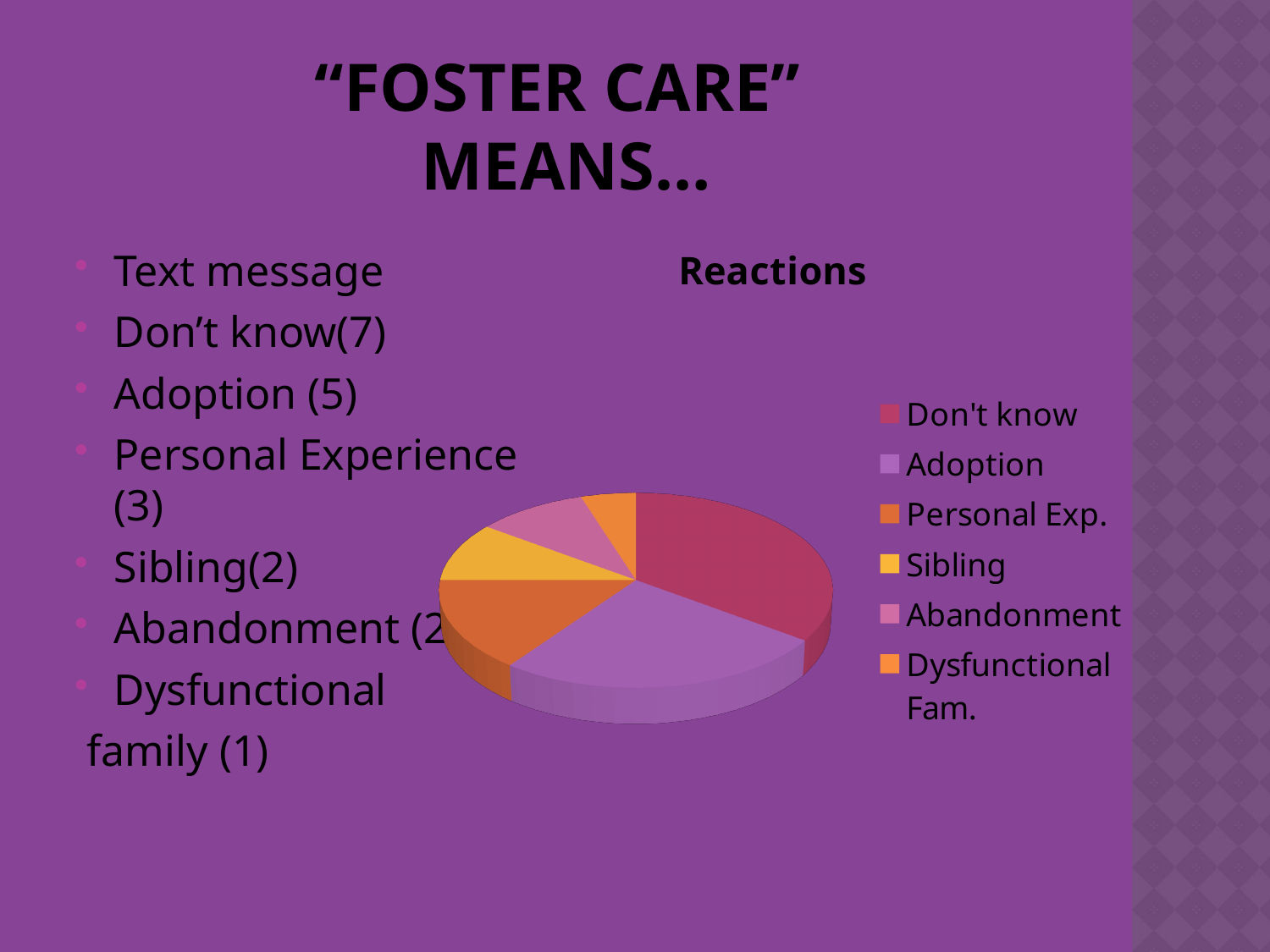
Which slice is larger, Adoption or Personal Exp.? Adoption How many slices does the pie chart have? 6 Which slice is larger, Personal Exp. or Dysfunctional Fam.? Personal Exp. Which slice is larger, Abandonment or Dysfunctional Fam.? Abandonment What colour is the Sibling slice in the pie chart? yellow How many entries does the chart legend list? 6 Which category has the largest slice of the pie? Don't know What is the title of the chart? Reactions Which category has the smallest slice of the pie? Dysfunctional Fam. What kind of chart is shown on the slide? pie chart